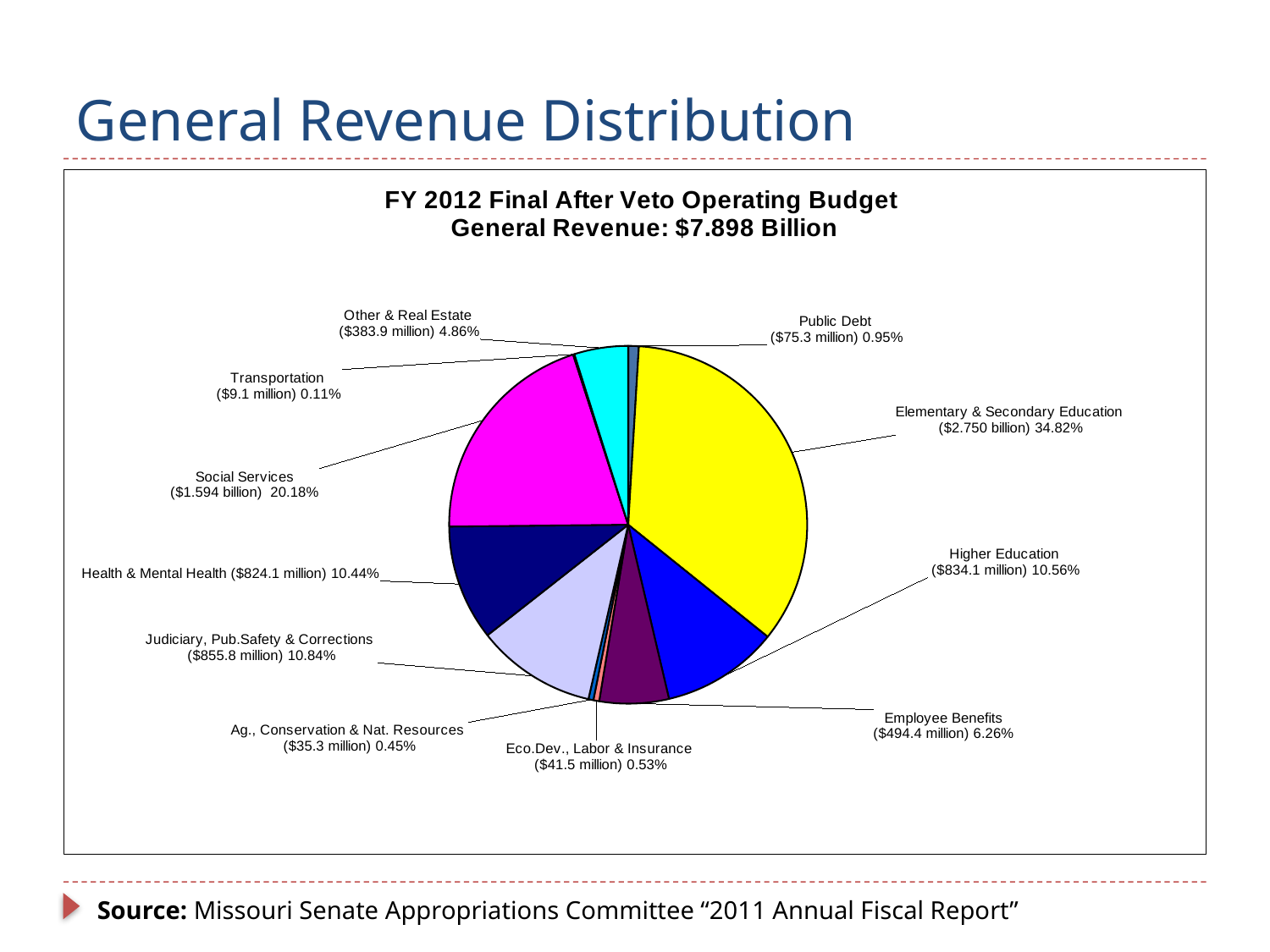
What is the dollar amount for Higher Education? $834.1 million What share of general revenue goes to Elementary & Secondary Education? 34.82% What is the dollar amount for Social Services? $1.594 billion How many slices does the pie chart have? 11 What is the difference in percentage points between the Elementary & Secondary Education share and the Social Services share? 14.64 What kind of chart is shown on the slide? Pie chart What is the title of the chart? FY 2012 Final After Veto Operating Budget General Revenue: $7.898 Billion What is the dollar amount for Public Debt? $75.3 million Which category receives the smallest share of general revenue? Transportation What share of general revenue goes to Employee Benefits? 6.26% Which is larger, the share for Judiciary, Pub.Safety & Corrections or the share for Health & Mental Health? Judiciary, Pub.Safety & Corrections Which category receives the largest share of general revenue? Elementary & Secondary Education